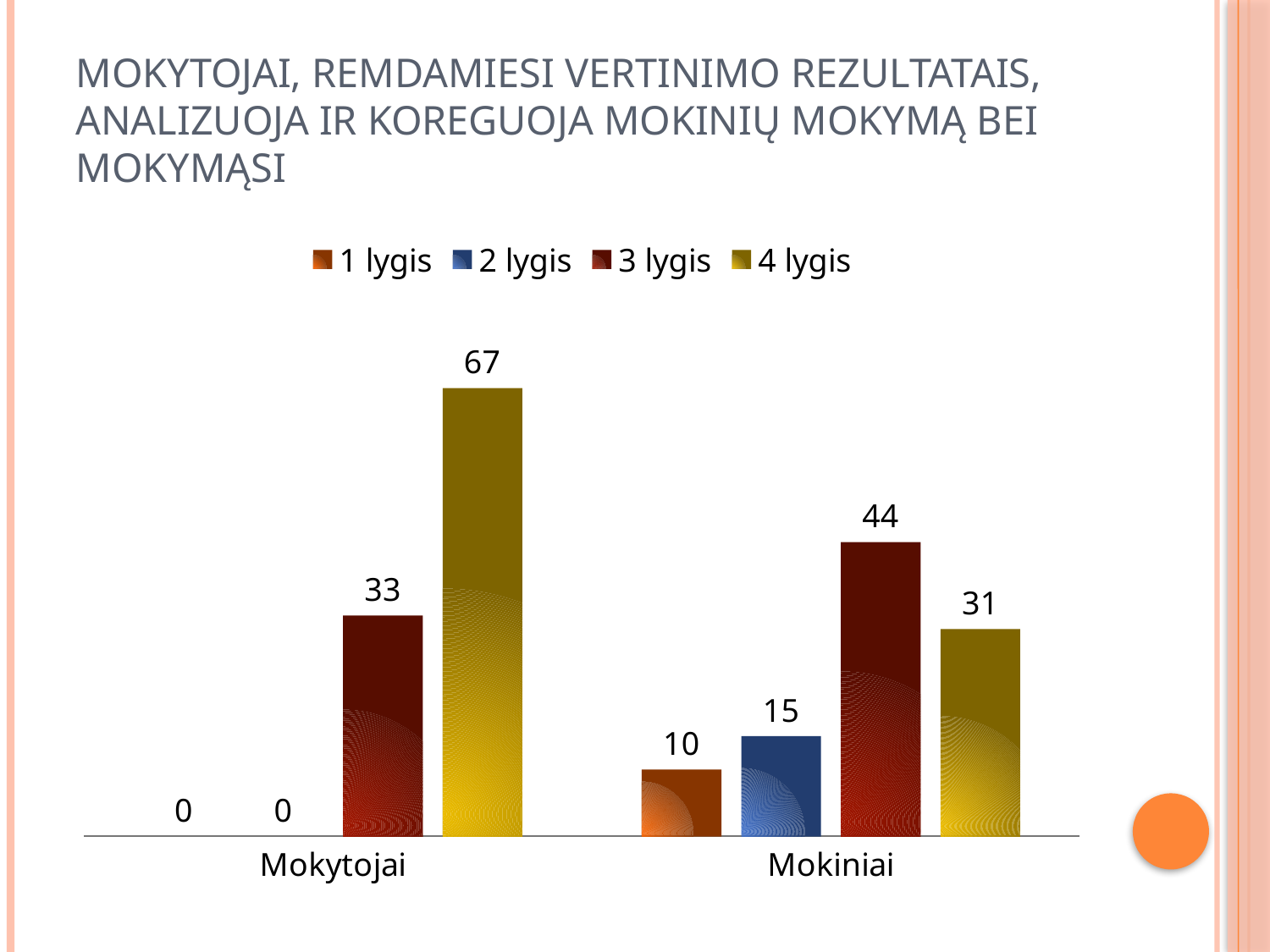
What is the value for 2 lygis in the Mokiniai category? 15 Which series has the highest value in the Mokiniai category? 3 lygis Which is larger: the 3 lygis value for Mokytojai or the 3 lygis value for Mokiniai? Mokiniai What is the difference between the 3 lygis and 4 lygis values in the Mokiniai category? 13 What kind of chart is shown on the slide? Bar chart What is the difference between the 4 lygis values for Mokytojai and Mokiniai? 36 What is the value for 4 lygis in the Mokytojai category? 67 How many series does the legend list? 4 How many categories are shown on the x axis? 2 Which series has the lowest value in the Mokiniai category? 1 lygis What is the value for 1 lygis in the Mokytojai category? 0 What is the value for 3 lygis in the Mokiniai category? 44